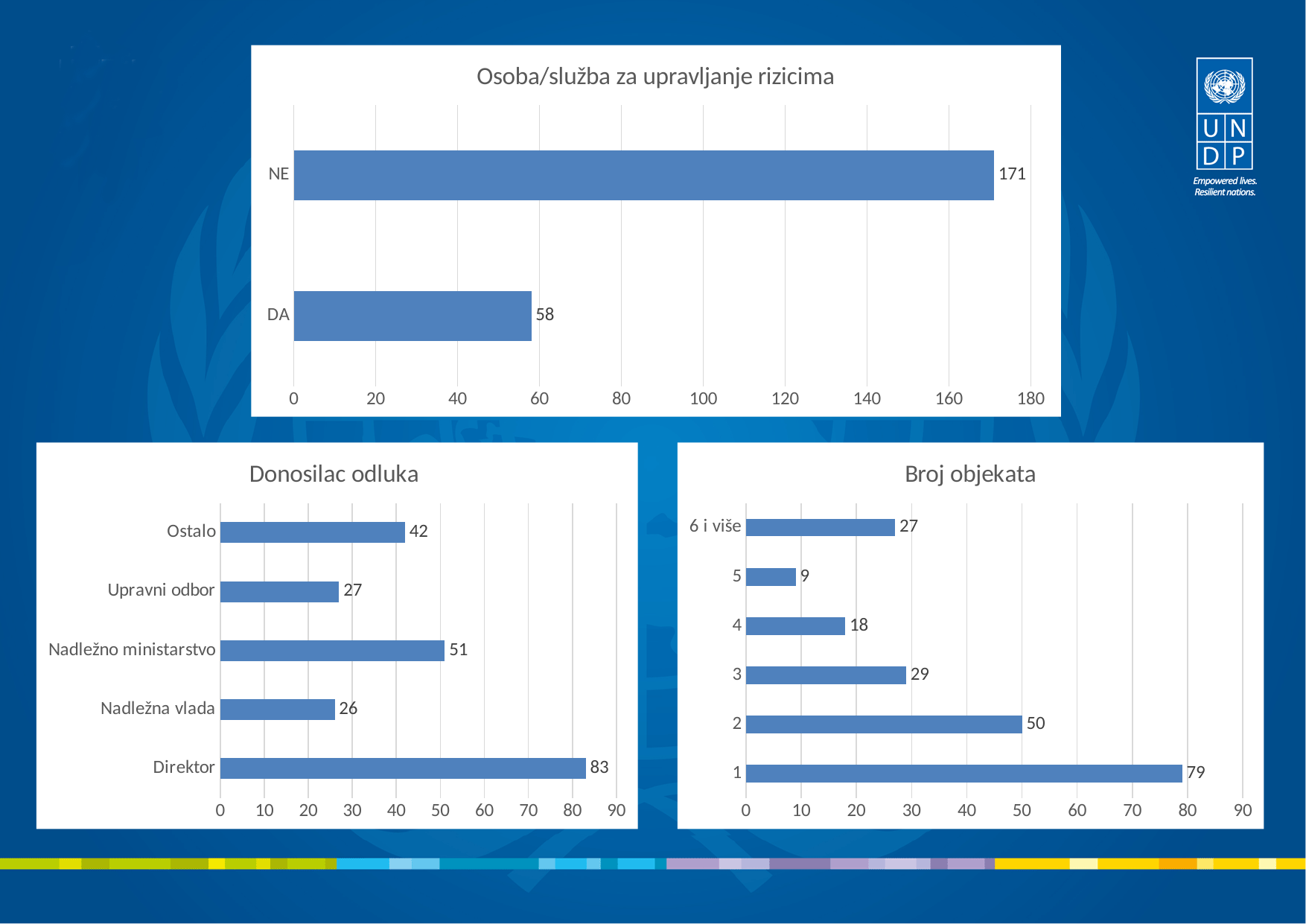
In the 'Donosilac odluka' chart, which category has the highest value? Direktor In the 'Donosilac odluka' chart, how many categories are shown? 5 In the 'Osoba/služba za upravljanje rizicima' chart, what is the difference between the NE and DA values? 113 In the 'Broj objekata' chart, which category has the lowest value? 5 In the 'Osoba/služba za upravljanje rizicima' chart, how many categories are shown? 2 In the 'Osoba/služba za upravljanje rizicima' chart, what is the value for NE? 171 In the 'Donosilac odluka' chart, which category has the lowest value? Nadležna vlada In the 'Broj objekata' chart, which is larger: the value for 2 or the value for 6 i više? 2 In the 'Donosilac odluka' chart, what is the value for Nadležno ministarstvo? 51 What type of chart is the 'Broj objekata' chart? Bar chart In the 'Broj objekata' chart, what is the value for category 3? 29 In the 'Broj objekata' chart, what is the difference between the values for 1 and 2? 29